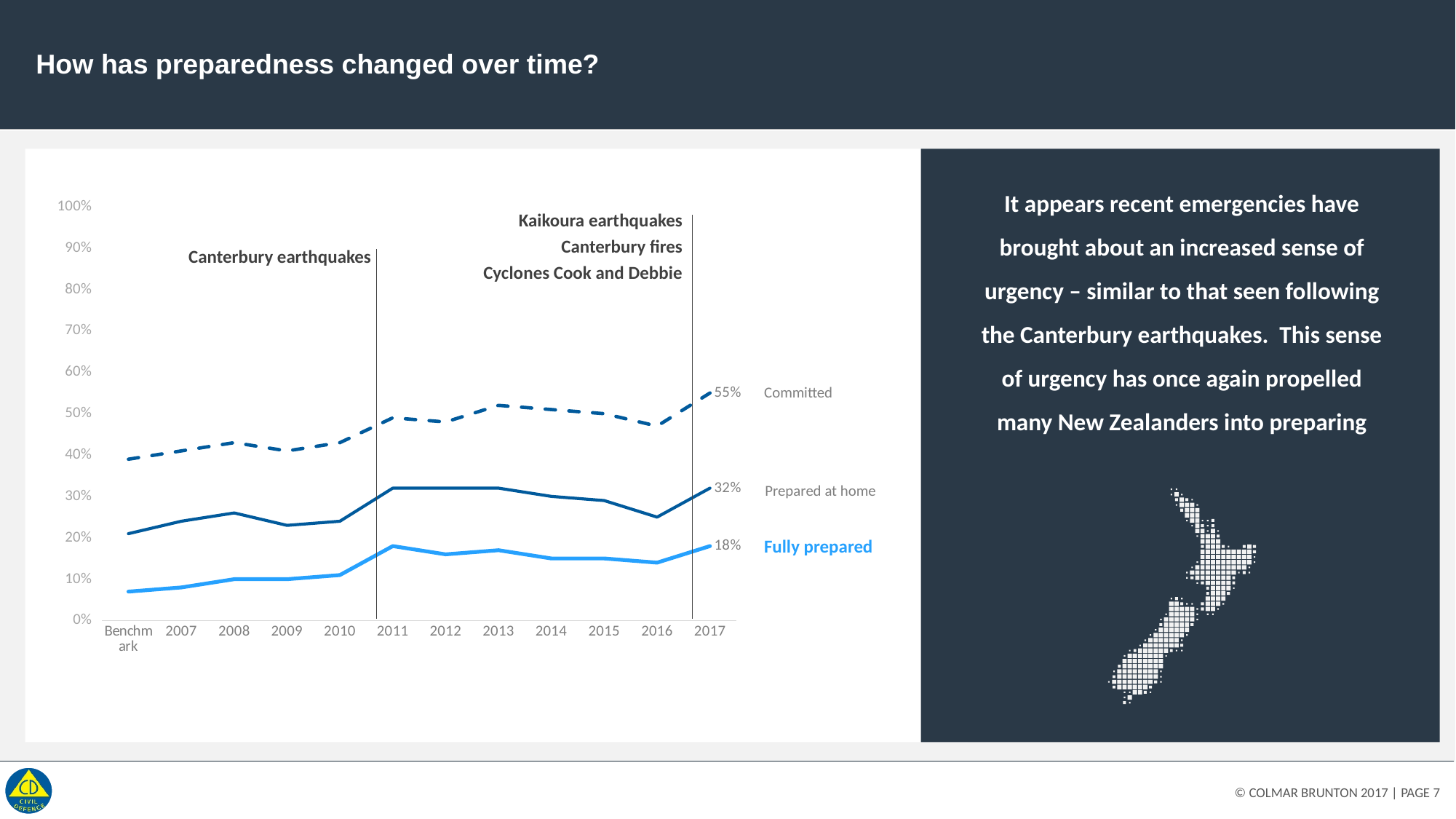
Which series is drawn with a dashed line? Committed What is the value for Fully prepared in 2017? 18% Is the value for Fully prepared at the Benchmark point greater or less than 10%? less What is the value for Committed in 2017? 55% What kind of chart is shown on the slide? line chart Which series has the highest value in 2017? Committed What is the difference between the Committed and Prepared at home values in 2017? 23 percentage points How many series are plotted on the chart? 3 What is the value for Prepared at home in 2017? 32% Is the value for Prepared at home in 2016 greater or less than 20%? greater How many points are shown along the x axis? 12 What is the difference between the Prepared at home and Fully prepared values in 2017? 14 percentage points